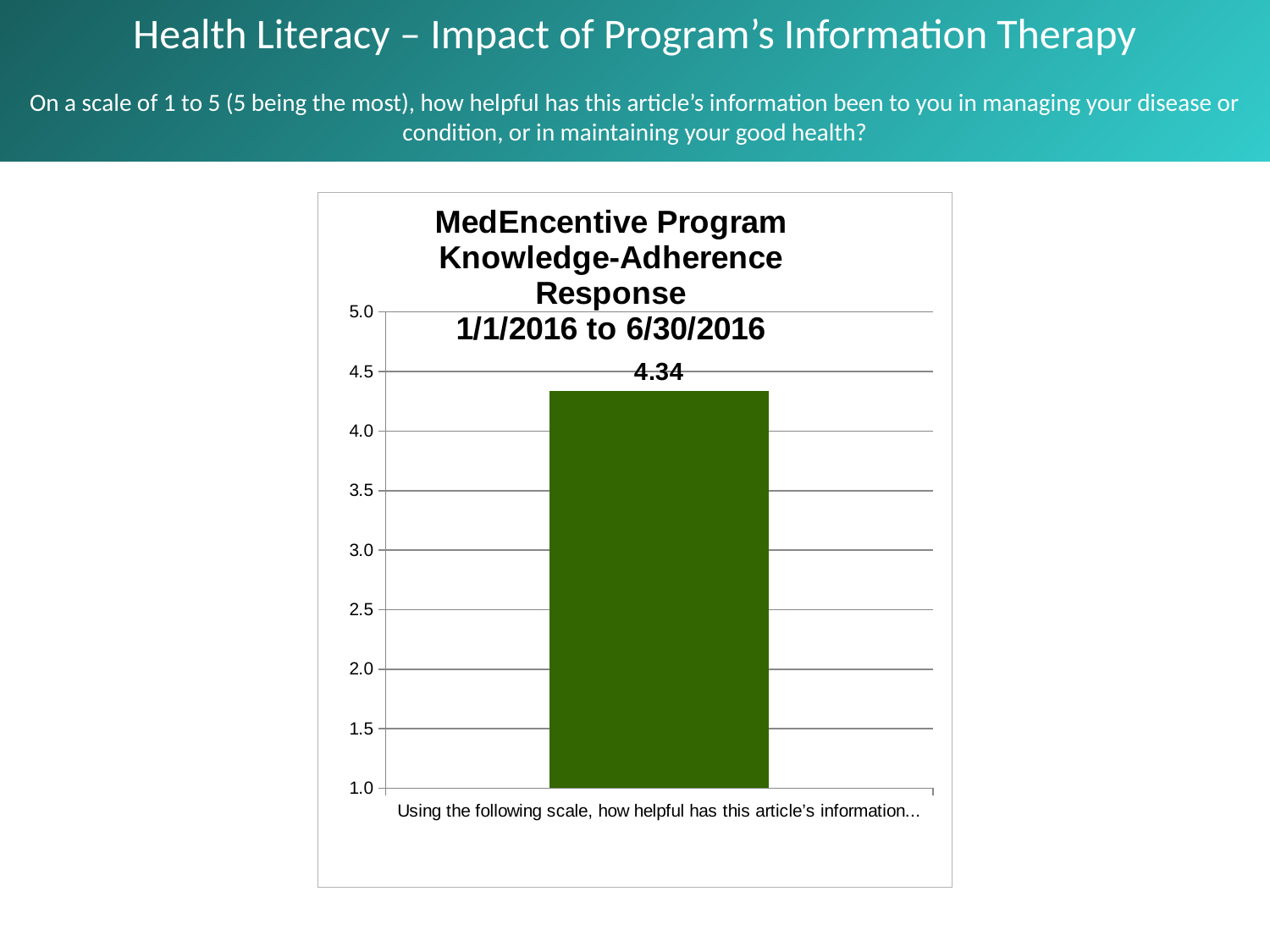
Is the value of the bar greater or less than 4.5? less What date range is given in the chart title? 1/1/2016 to 6/30/2016 What kind of chart is shown on the slide? bar chart Is the value of the bar greater or less than 4.0? greater How many bars does the chart contain? 1 What value is shown by the bar in the chart? 4.34 What is the minimum value shown on the vertical axis? 1.0 What is the maximum value shown on the vertical axis? 5.0